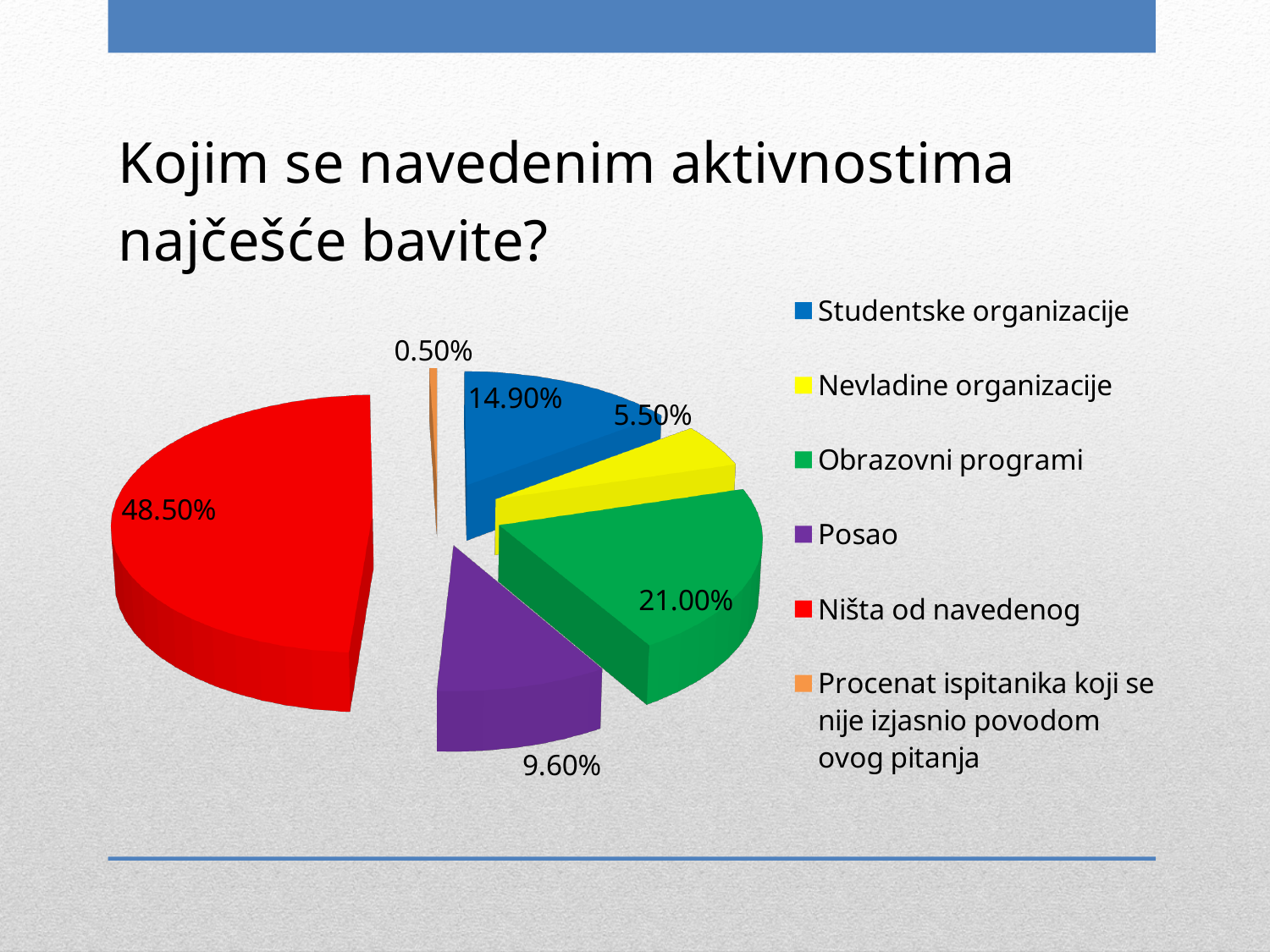
Which category has the largest slice of the pie? Ništa od navedenog What is the difference between the percentages for Obrazovni programi and Studentske organizacije? 6.10% What percentage is shown for Ništa od navedenog? 48.50% What percentage is shown for Obrazovni programi? 21.00% What colour is the slice for Obrazovni programi? green Which is larger, the slice for Posao or the slice for Nevladine organizacije? Posao Which category has the smallest slice of the pie? Procenat ispitanika koji se nije izjasnio povodom ovog pitanja What kind of chart is shown on the slide? pie chart What percentage is shown for Posao? 9.60% What percentage is shown for Studentske organizacije? 14.90% How many categories does the legend list? 6 What percentage is shown for Nevladine organizacije? 5.50%